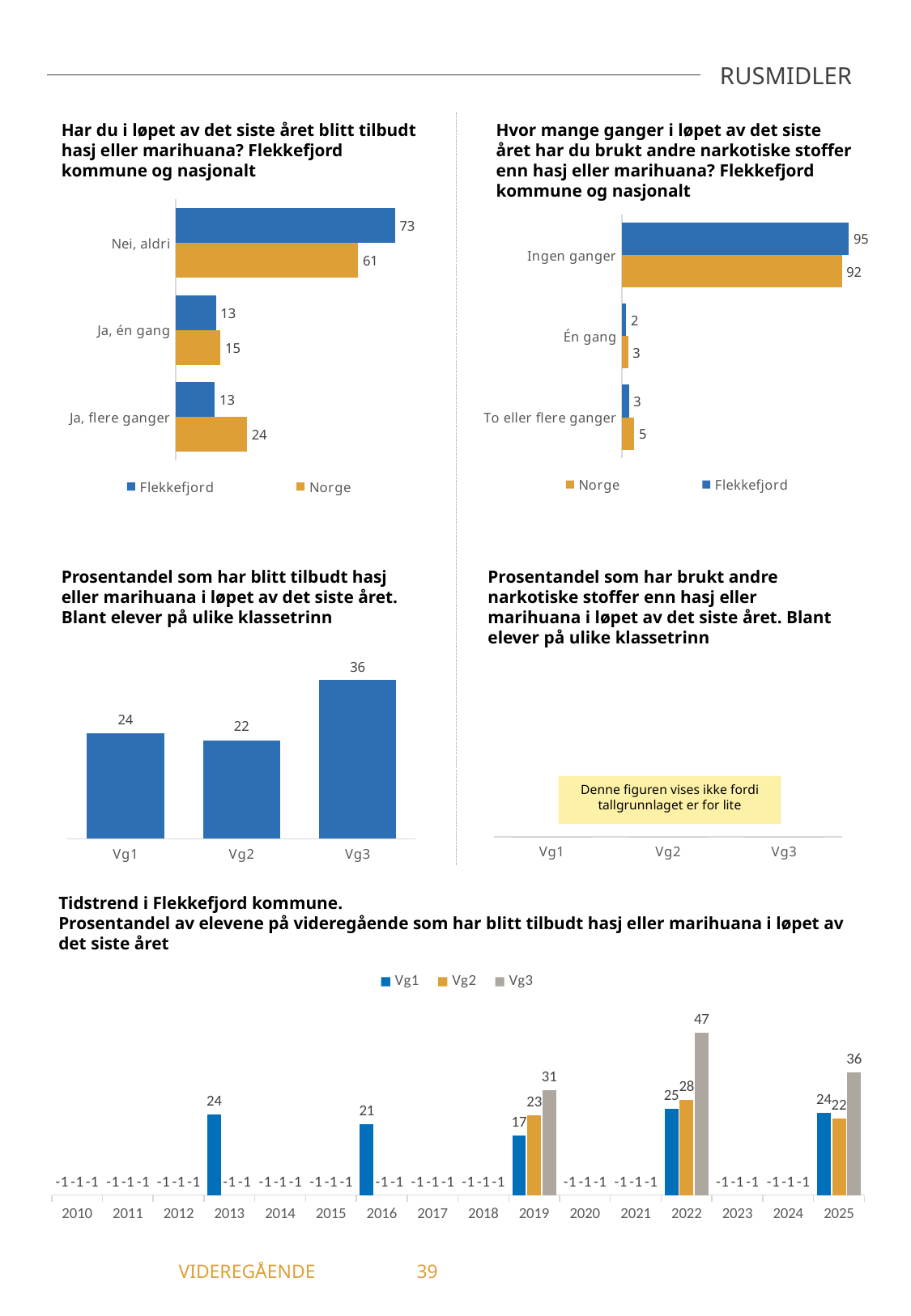
In the chart 'Hvor mange ganger i løpet av det siste året har du brukt andre narkotiske stoffer enn hasj eller marihuana?', what is the value for Norge in 'Ingen ganger'? 92 In the chart 'Har du i løpet av det siste året blitt tilbudt hasj eller marihuana?', what is the value for Flekkefjord in the 'Nei, aldri' category? 73 In the chart 'Prosentandel som har blitt tilbudt hasj eller marihuana i løpet av det siste året. Blant elever på ulike klassetrinn', what is the value for Vg2? 22 In the chart 'Tidstrend i Flekkefjord kommune', what is the value for Vg3 in 2022? 47 In the chart 'Har du i løpet av det siste året blitt tilbudt hasj eller marihuana?', what is the difference between Norge and Flekkefjord for 'Ja, flere ganger'? 11 In the chart 'Har du i løpet av det siste året blitt tilbudt hasj eller marihuana?', which is larger for 'Ja, én gang': Flekkefjord or Norge? Norge In the chart 'Tidstrend i Flekkefjord kommune', what is the value for Vg1 in 2019? 17 What kind of chart is 'Prosentandel som har blitt tilbudt hasj eller marihuana i løpet av det siste året. Blant elever på ulike klassetrinn'? Bar chart In the chart 'Tidstrend i Flekkefjord kommune', what is the difference between Vg3 and Vg2 in 2025? 14 In the chart 'Prosentandel som har blitt tilbudt hasj eller marihuana i løpet av det siste året. Blant elever på ulike klassetrinn', which class level has the highest value? Vg3 In the chart 'Hvor mange ganger i løpet av det siste året har du brukt andre narkotiske stoffer enn hasj eller marihuana?', what is the value for Flekkefjord in 'To eller flere ganger'? 3 How many series does the legend list in the chart 'Hvor mange ganger i løpet av det siste året har du brukt andre narkotiske stoffer enn hasj eller marihuana?'? 2